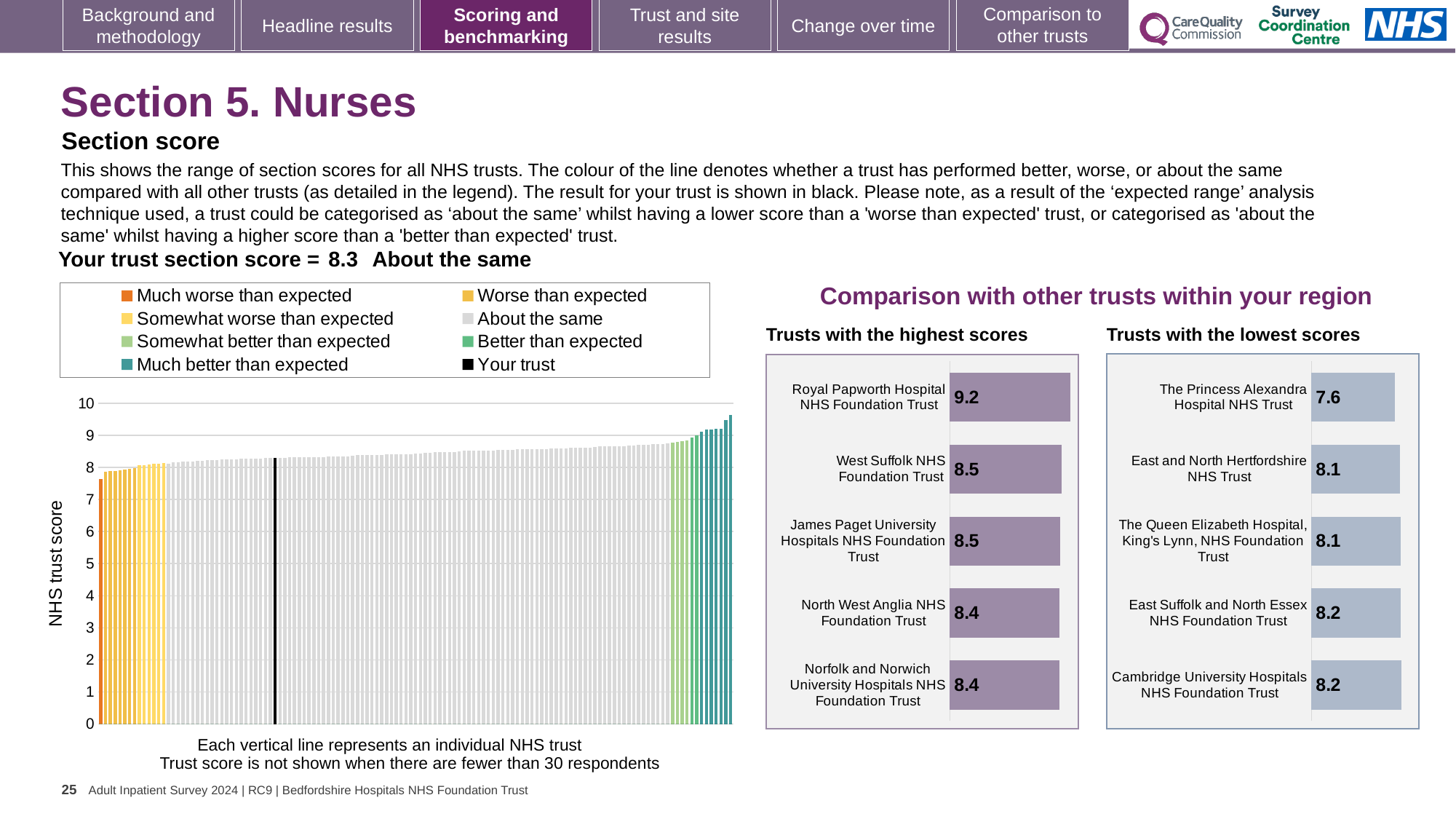
In the 'Trusts with the lowest scores' chart, how much higher is Cambridge University Hospitals NHS Foundation Trust's score than The Princess Alexandra Hospital NHS Trust's score? 0.6 In the 'Trusts with the highest scores' chart, what is the score for Royal Papworth Hospital NHS Foundation Trust? 9.2 How many trusts are shown in the 'Trusts with the lowest scores' chart? 5 According to the slide, what is your trust's section score for Nurses? 8.3 In the 'Trusts with the highest scores' chart, which has the larger score: Royal Papworth Hospital NHS Foundation Trust or North West Anglia NHS Foundation Trust? Royal Papworth Hospital NHS Foundation Trust In the 'Trusts with the lowest scores' chart, what is the score for The Princess Alexandra Hospital NHS Trust? 7.6 In the 'Trusts with the highest scores' chart, which trust has the highest score? Royal Papworth Hospital NHS Foundation Trust What type of chart is the large chart on the left showing NHS trust scores? Bar chart In the 'Trusts with the highest scores' chart, what is the difference between the scores of Royal Papworth Hospital NHS Foundation Trust and West Suffolk NHS Foundation Trust? 0.7 How many trusts are shown in the 'Trusts with the highest scores' chart? 5 In the 'Trusts with the lowest scores' chart, which trust has the lowest score? The Princess Alexandra Hospital NHS Trust How many entries does the legend of the large NHS trust score chart list? 8